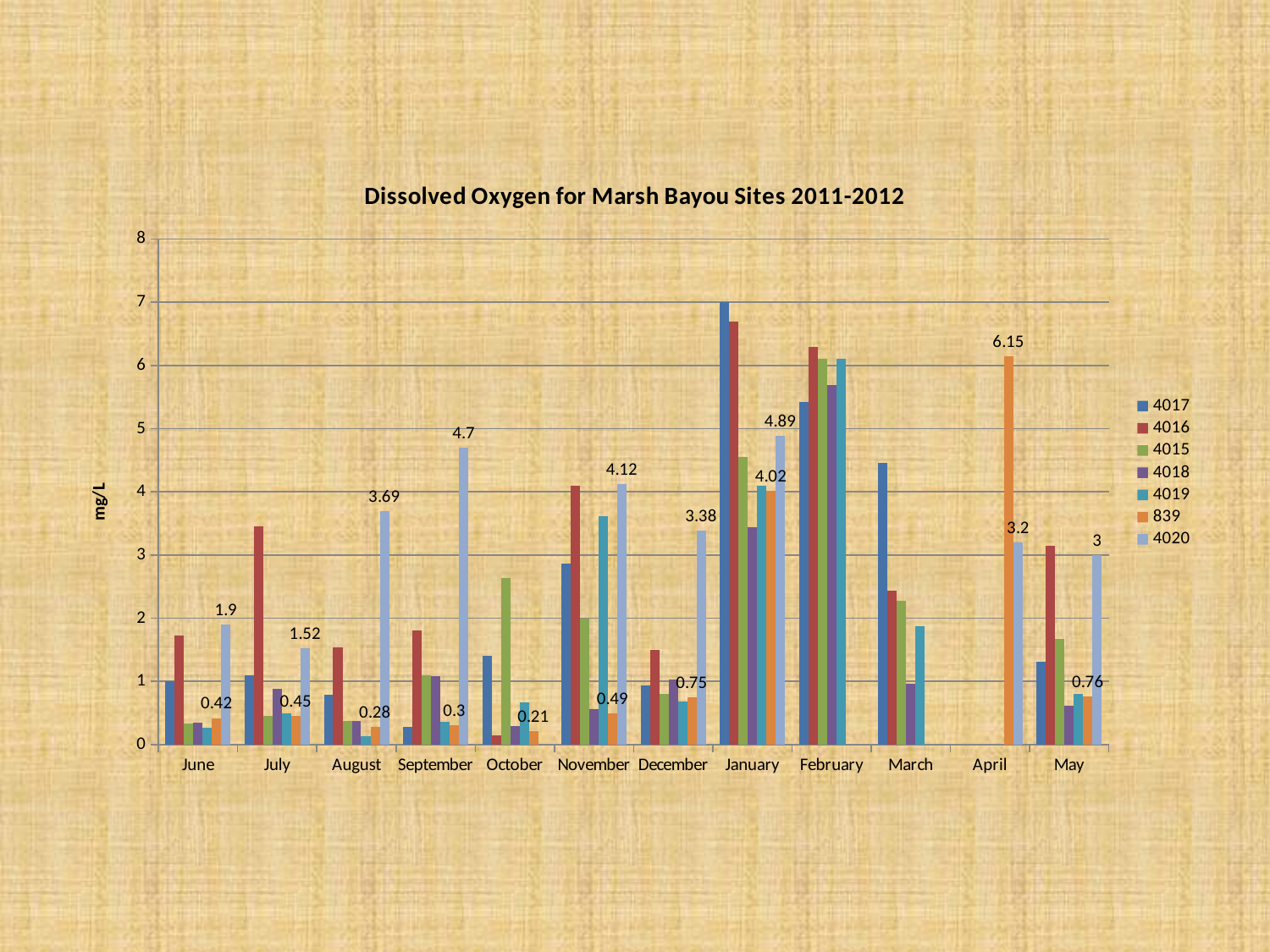
What is the value for site 839 in October? 0.21 How many series does the legend list? 7 What is the value for site 839 in April? 6.15 Is the value for site 4017 in January greater or less than 6? greater What is the difference between the values for site 4020 and site 839 in January? 0.87 In which month does site 4020 have its highest value? January What is the difference between the values for site 4020 and site 839 in June? 1.48 In which month does site 839 have its lowest value? October What is the value for site 4020 in September? 4.7 What kind of chart is shown on the slide? Bar chart How many months are shown on the x axis? 12 In April, which site has the larger value, 839 or 4020? 839